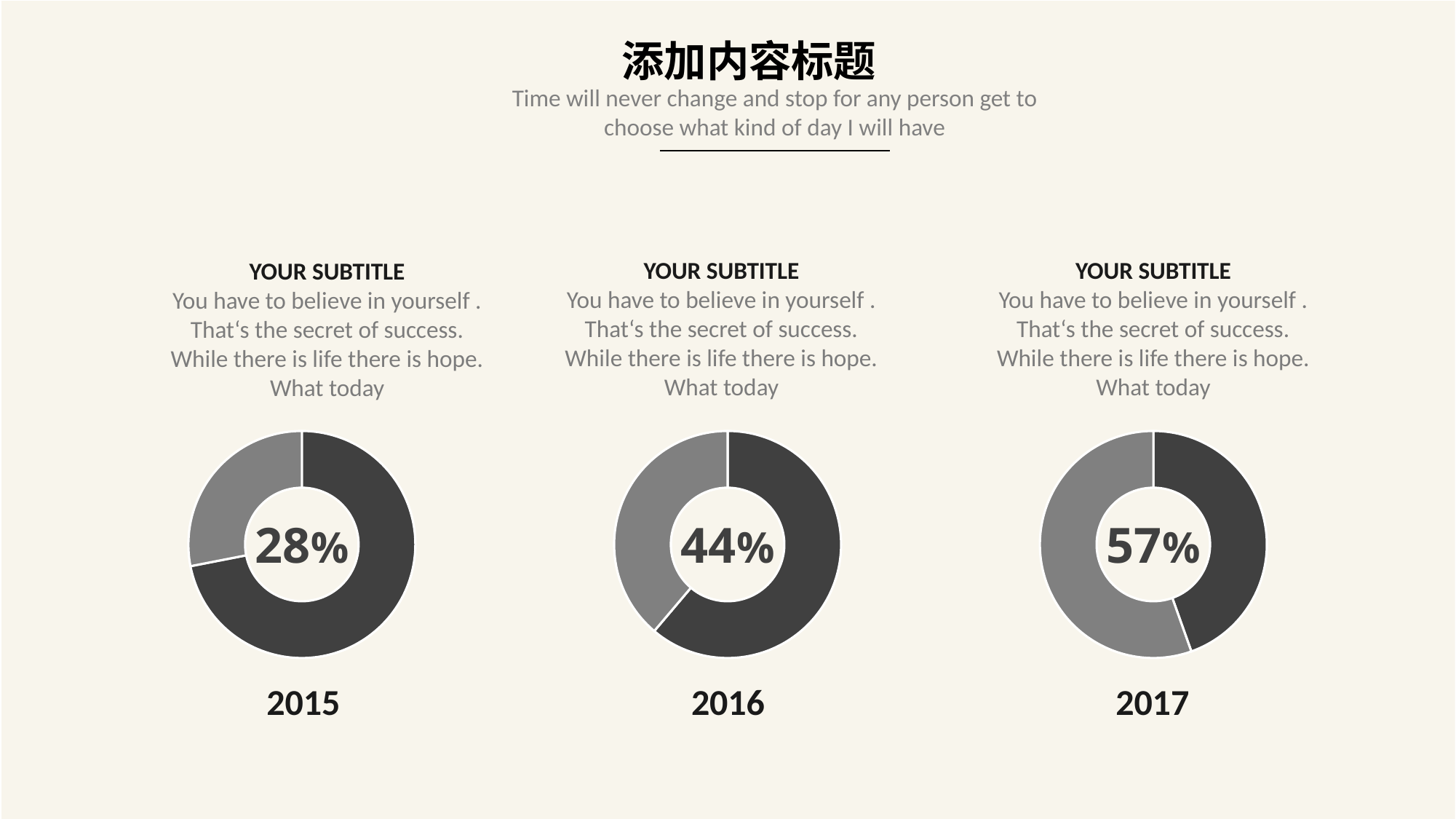
Which is larger, the percentage shown for 2016 or the percentage shown for 2017? 2017 What is the difference between the percentage shown for 2016 and the percentage shown for 2015? 16% What percentage is shown in the centre of the 2016 donut chart? 44% How many segments does each donut chart have? 2 Which year's donut chart shows the highest percentage? 2017 Which year's donut chart shows the lowest percentage? 2015 What is the difference between the percentage shown for 2017 and the percentage shown for 2015? 29% What kind of chart is used for each year on the slide? donut chart What percentage is shown in the centre of the 2017 donut chart? 57% What percentage is shown in the centre of the 2015 donut chart? 28% Do the percentages shown in the donut charts rise or fall from 2015 to 2017? rise How many donut charts are on the slide? 3